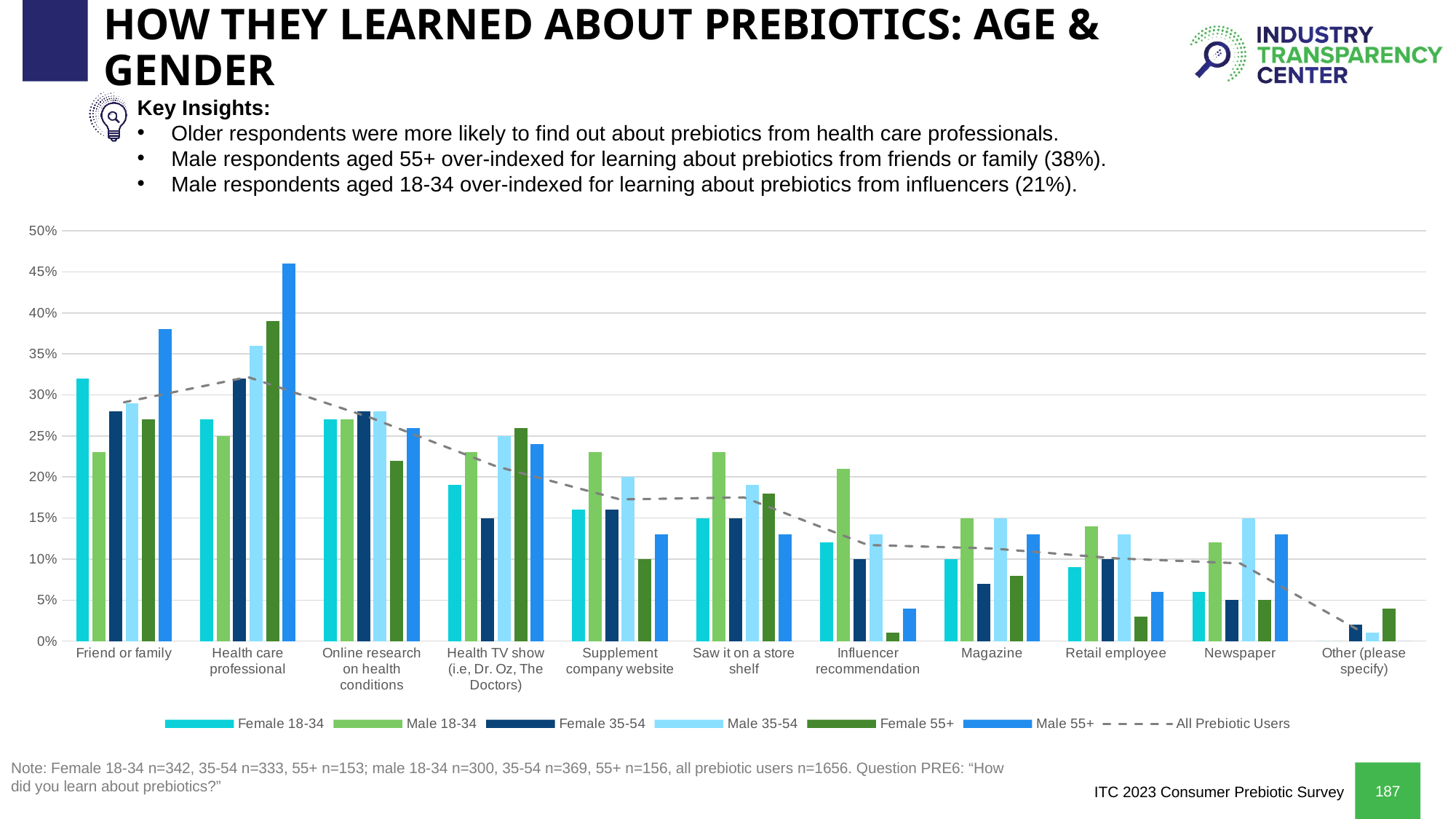
Does the All Prebiotic Users dashed line generally rise or fall from left to right across the categories? Fall Which series is represented by the dashed grey line in the chart? All Prebiotic Users How many categories are shown along the x axis of the chart? 11 How many series does the chart legend list? 7 Which category has the highest value for Male 55+? Health care professional Is the value for Male 55+ in the Health care professional category greater or less than 40%? greater What type of chart is shown on the slide? Combination bar and line chart Which is larger for the Friend or family category: Female 18-34 or Male 18-34? Female 18-34 Is the value for Female 18-34 in the Friend or family category greater or less than 30%? greater Which is larger for the Friend or family category: Male 55+ or Female 55+? Male 55+ Is the value for Female 55+ in the Influencer recommendation category greater or less than 5%? less Which category has the lowest values across all series? Other (please specify)